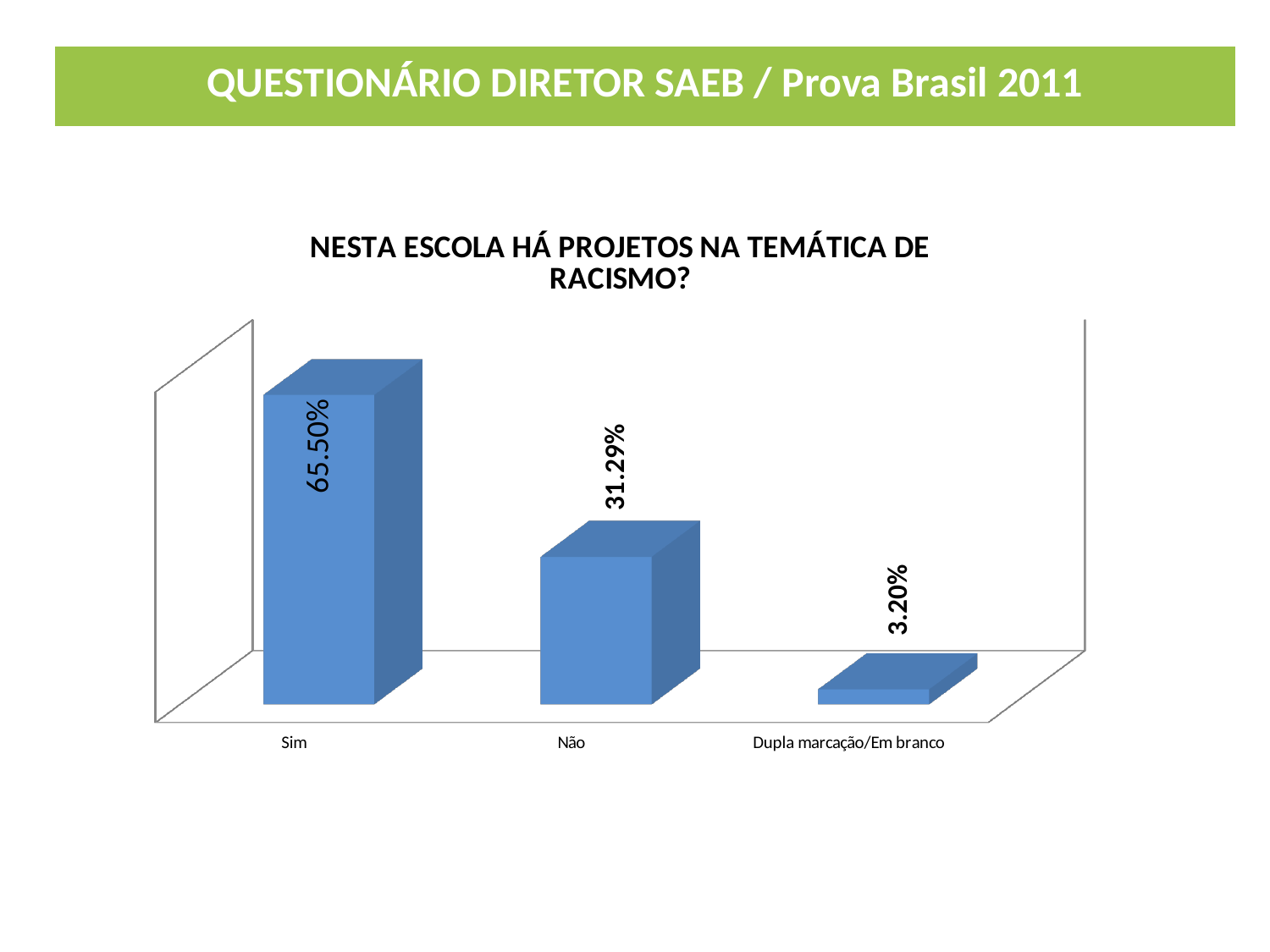
What kind of chart is shown on the slide? bar chart How many categories are shown on the x axis? 3 What is the difference between the values for Sim and Não? 34.21% What is the value for Não? 31.29% Which is larger, the value for Sim or the value for Não? Sim Do the values rise or fall from left to right along the x axis? fall Which category has the highest value? Sim What is the title of the chart? NESTA ESCOLA HÁ PROJETOS NA TEMÁTICA DE RACISMO? Which category has the lowest value? Dupla marcação/Em branco What is the value for Dupla marcação/Em branco? 3.20% What is the difference between the values for Não and Dupla marcação/Em branco? 28.09% What is the value for Sim? 65.50%